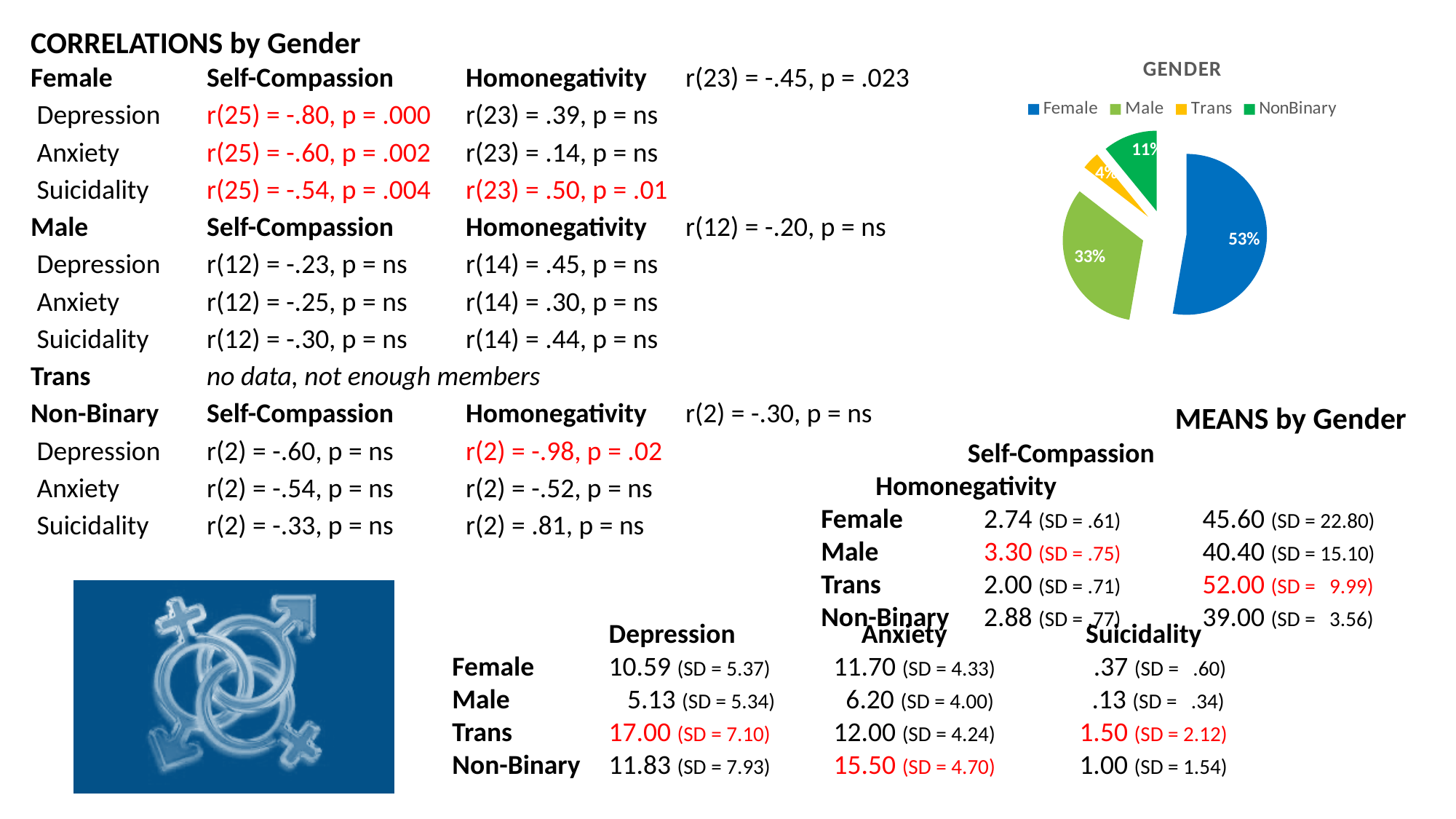
What share of the GENDER pie chart is Trans? 4% Which category has the largest slice in the GENDER pie chart? Female In the GENDER pie chart, which is larger, the Male slice or the NonBinary slice? Male What is the title of the pie chart? GENDER How many categories does the legend of the GENDER pie chart list? 4 In the GENDER pie chart, what is the difference in percentage points between the Female and Male slices? 20 What share of the GENDER pie chart is Female? 53% What share of the GENDER pie chart is Male? 33% Which category has the smallest slice in the GENDER pie chart? Trans What kind of chart is the GENDER chart? pie chart What colour is the Female slice in the GENDER pie chart? blue